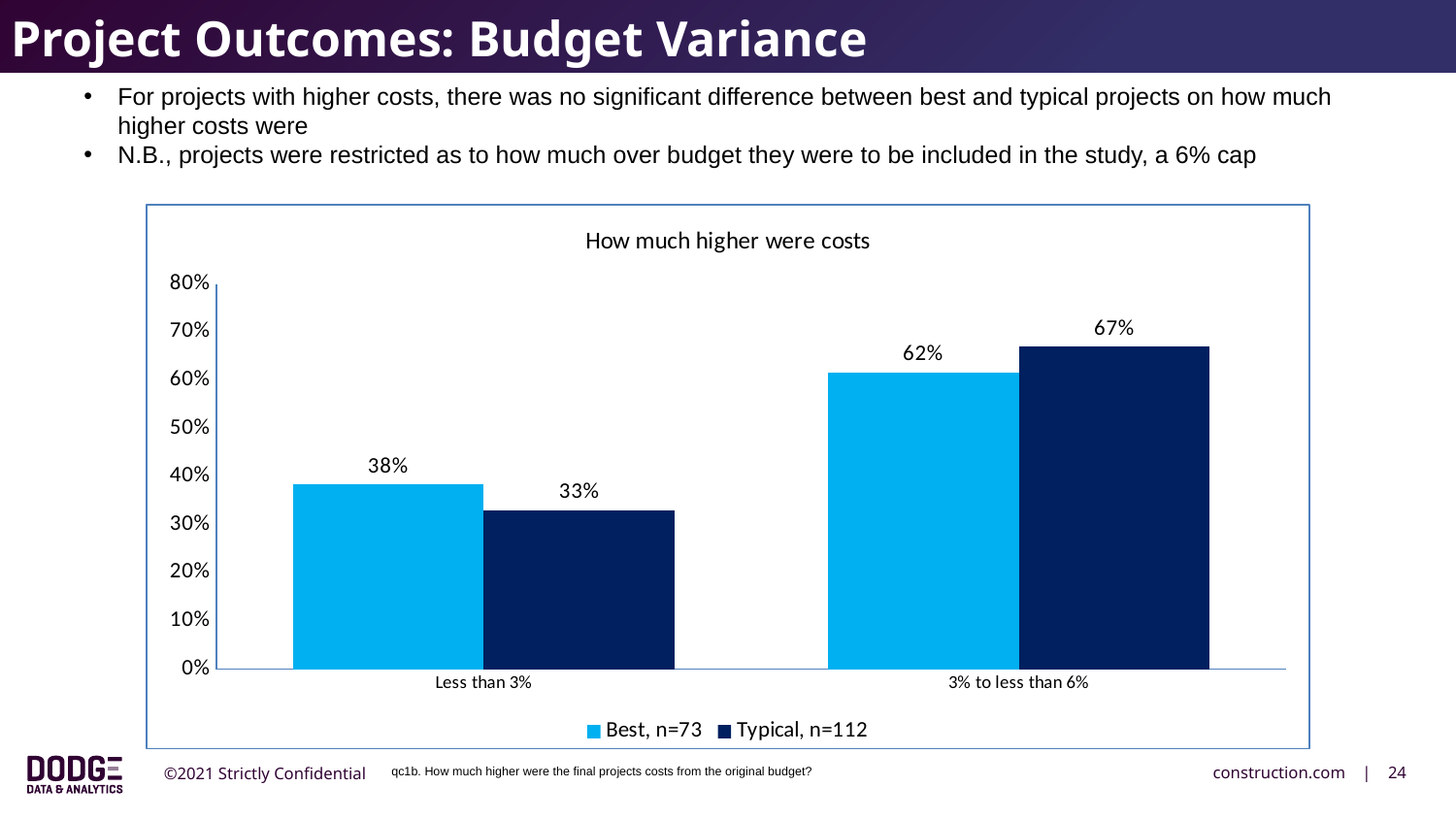
What is the value for Best, n=73 in the '3% to less than 6%' category? 62% What is the title of the chart? How much higher were costs Which category has the highest value for Typical, n=112? 3% to less than 6% What is the difference between the Best and Typical values in the '3% to less than 6%' category? 5% What kind of chart is shown on the slide? Bar chart How many series does the legend list? 2 How many categories are shown on the x axis? 2 What is the value for Typical, n=112 in the 'Less than 3%' category? 33% What is the value for Typical, n=112 in the '3% to less than 6%' category? 67% In the 'Less than 3%' category, which series has the larger value, Best or Typical? Best, n=73 What is the value for Best, n=73 in the 'Less than 3%' category? 38% Which category has the lowest value for Best, n=73? Less than 3%